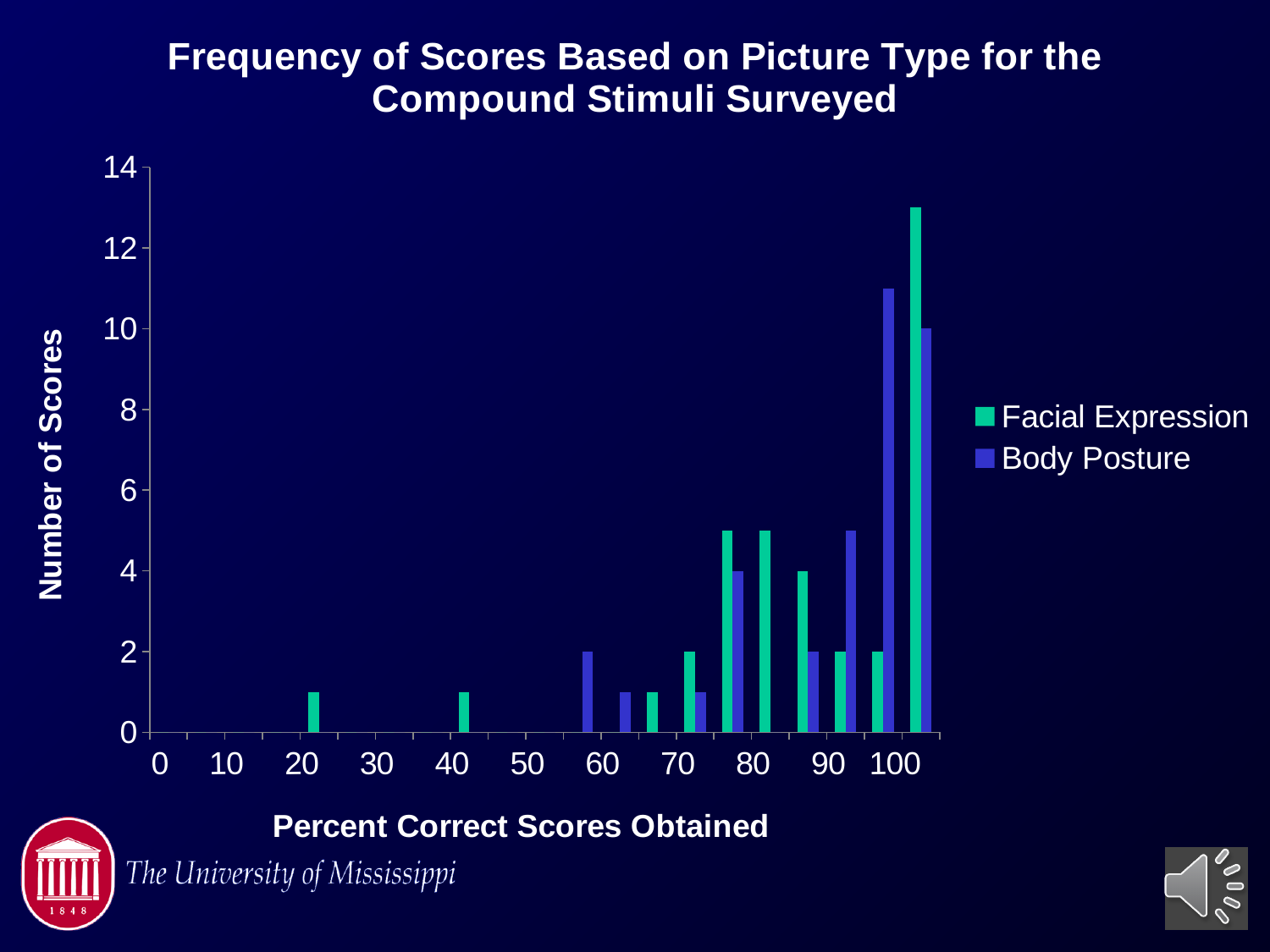
Which series has the tallest bar on the chart? Facial Expression Near the 100 percent mark, which series has the taller bar, Facial Expression or Body Posture? Facial Expression Is the tallest Facial Expression bar greater or less than 12? greater Is the Body Posture bar near 60 percent greater or less than 4? less Is the tallest Body Posture bar greater or less than 12? less Do the Facial Expression bars generally rise or fall as the percent correct score increases? rise How many series does the legend list? 2 What is the title of the vertical axis? Number of Scores What is the value of the Body Posture bar at the far right of the chart? 10 What kind of chart is shown on the slide? Bar chart What are the two series named in the legend? Facial Expression and Body Posture